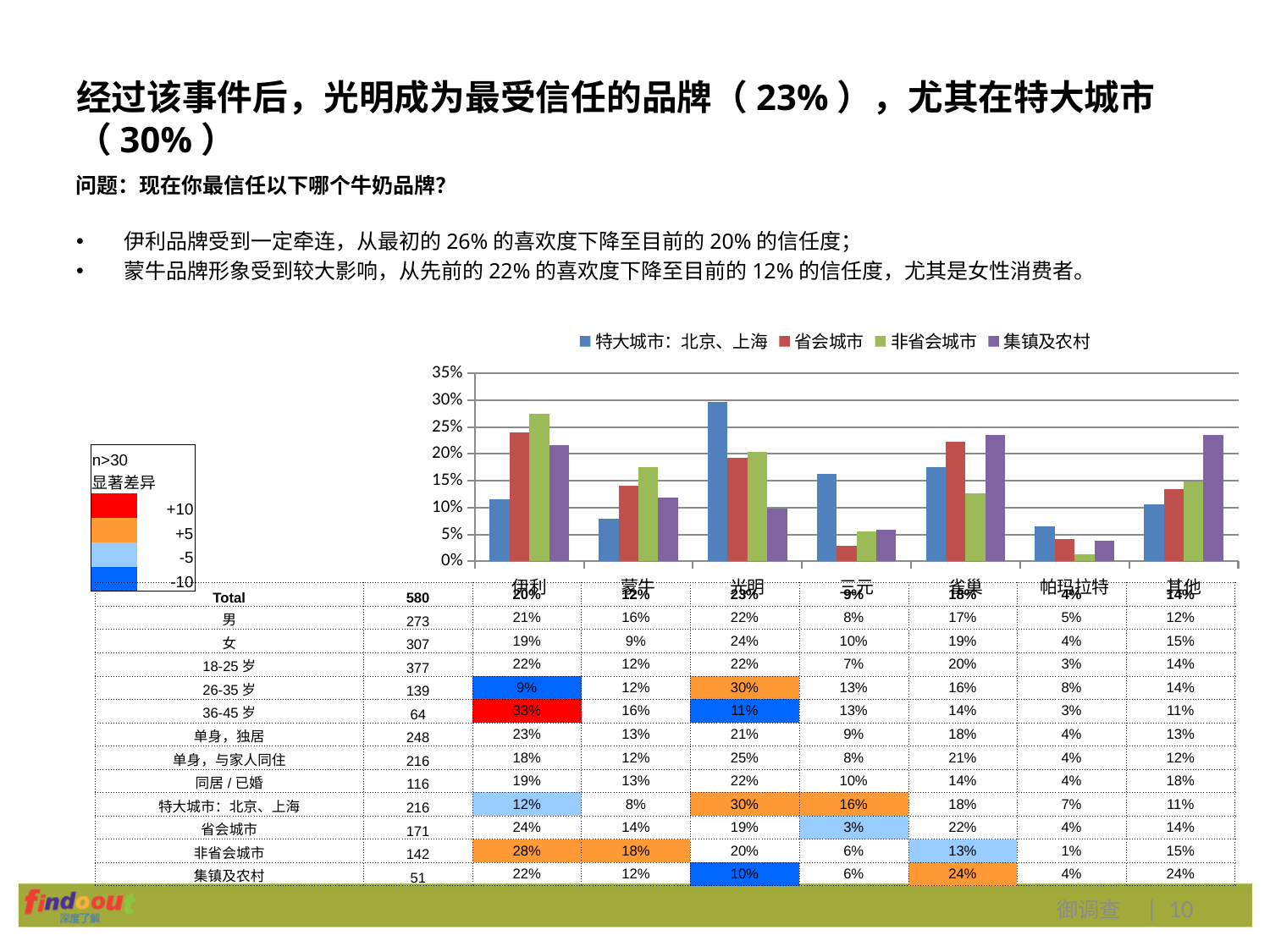
Is the value for 非省会城市 at 帕玛拉特 greater or less than 5%? less How many brand categories are plotted along the x axis of the chart? 7 For 三元, which series has the lowest bar? 省会城市 For 光明, which series has the highest bar? 特大城市：北京、上海 Among the 特大城市：北京、上海 series, which brand has the highest bar? 光明 What kind of chart is shown on the slide? bar chart What colour are the bars for the 特大城市：北京、上海 series? blue For 雀巢, which is larger: the 集镇及农村 bar or the 非省会城市 bar? 集镇及农村 How many series does the chart legend list? 4 Is the value for 特大城市：北京、上海 at 光明 greater or less than 25%? greater For 伊利, which is larger: the 非省会城市 bar or the 特大城市：北京、上海 bar? 非省会城市 Is the value for 集镇及农村 at 光明 greater or less than 15%? less